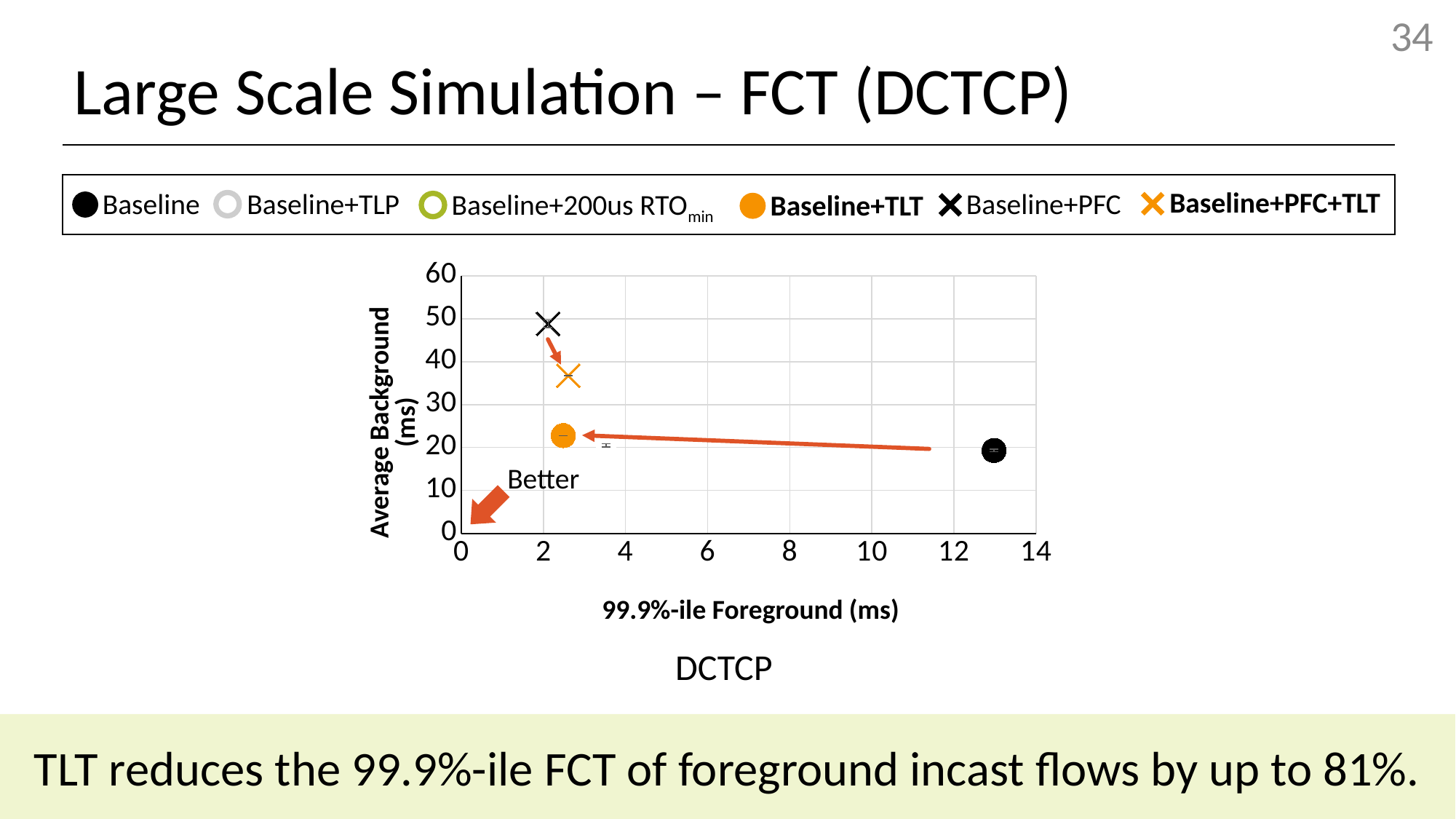
Is the Average Background value for Baseline+TLT greater or less than 30? less Is the Average Background value for Baseline+PFC+TLT greater or less than 30? greater Is the Average Background value for Baseline+PFC greater or less than 40? greater Which has the larger 99.9%-ile Foreground value, Baseline or Baseline+TLT? Baseline How many series does the legend list? 6 What kind of chart is shown on the slide? scatter chart What is the title of the x axis? 99.9%-ile Foreground (ms) Which has the higher Average Background value, Baseline+PFC or Baseline+PFC+TLT? Baseline+PFC What is the title of the y axis? Average Background (ms) Which plotted series has the highest Average Background value? Baseline+PFC